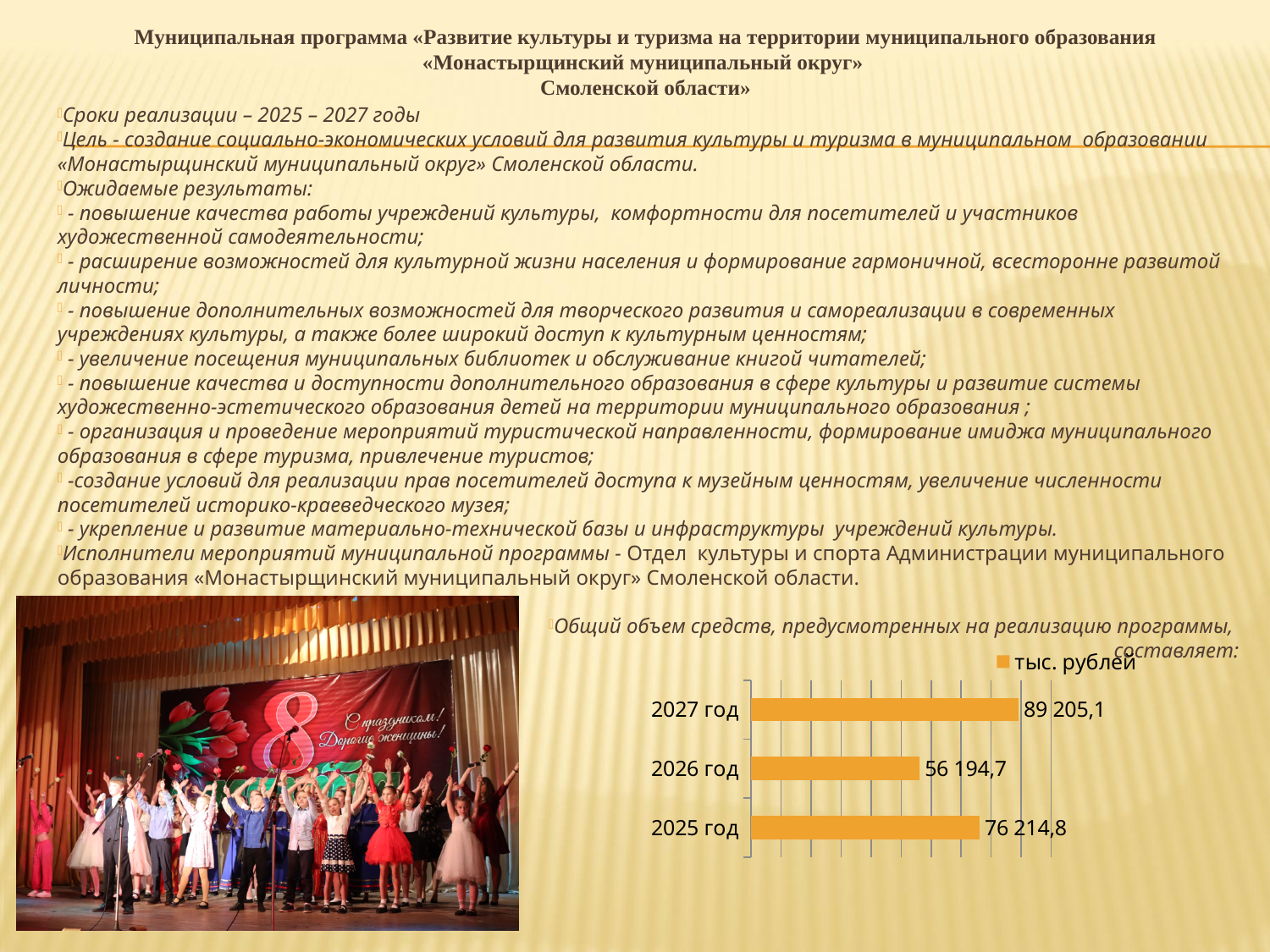
What is the difference between the values for 2027 год and 2025 год? 12 990,3 What is the value for 2025 год in the chart? 76 214,8 Which year has the highest value in the chart? 2027 год What is the value for 2027 год in the chart? 89 205,1 Which year has the lowest value in the chart? 2026 год What is the legend entry of the chart? тыс. рублей What kind of chart is shown on the slide? bar chart What is the value for 2026 год in the chart? 56 194,7 What is the difference between the values for 2025 год and 2026 год? 20 020,1 How many categories (years) are shown in the chart? 3 How many series does the chart legend list? 1 Which is larger, the value for 2025 год or the value for 2026 год? 2025 год